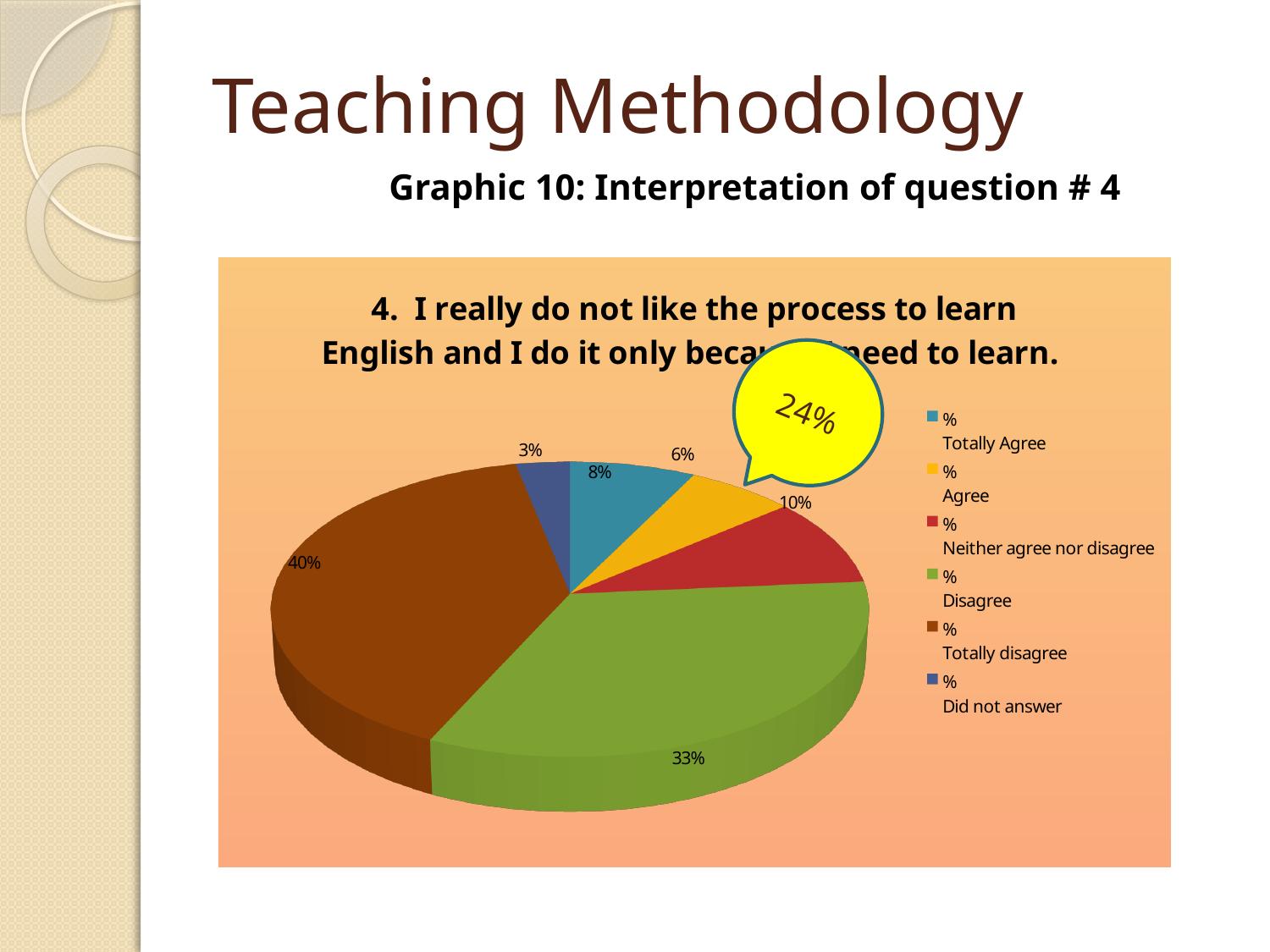
What percentage of respondents chose "Totally disagree"? 40% What percentage of respondents chose "Agree"? 6% Which response category has the smallest share of the pie? Did not answer How many response categories does the legend list? 6 Which is larger, the share for "Totally Agree" or the share for "Agree"? Totally Agree Which response category has the largest share of the pie? Totally disagree What percentage of respondents chose "Neither agree nor disagree"? 10% What kind of chart is shown on the slide? pie chart What percentage of respondents "Did not answer"? 3% What percentage of respondents chose "Disagree"? 33% What percentage of respondents chose "Totally Agree"? 8% What is the difference between the "Totally disagree" and "Disagree" shares? 7%